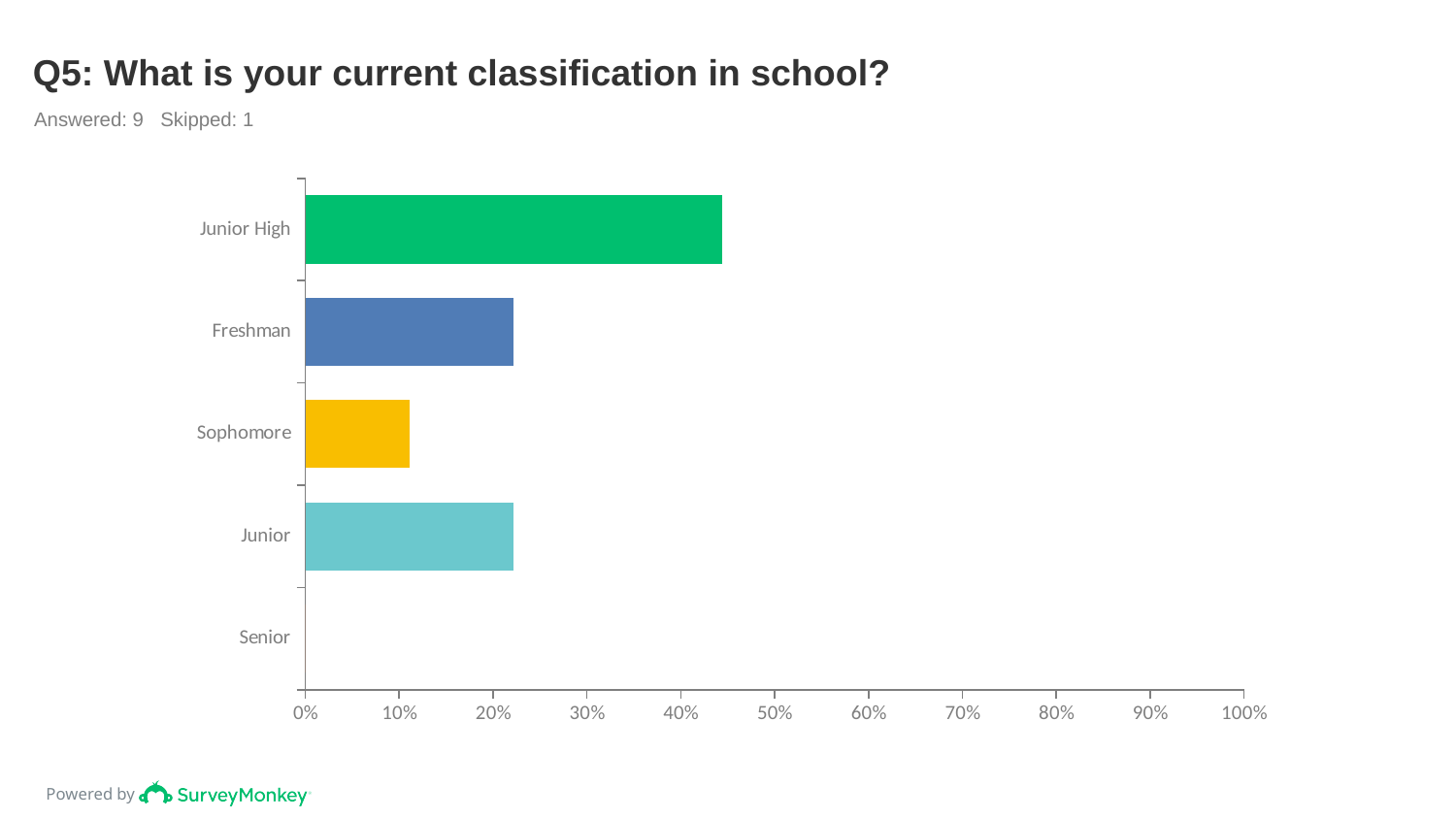
Which category has the highest value? Junior High How many categories are shown on the chart? 5 What is the title of the chart? Q5: What is your current classification in school? Which category has the lowest value? Senior Is the value for Junior greater or less than 30%? less Which is larger, the value for Junior High or the value for Junior? Junior High What kind of chart is shown on the slide? bar chart Which is larger, the value for Freshman or the value for Sophomore? Freshman Is the value for Freshman greater or less than 20%? greater Is the value for Junior High greater or less than 50%? less